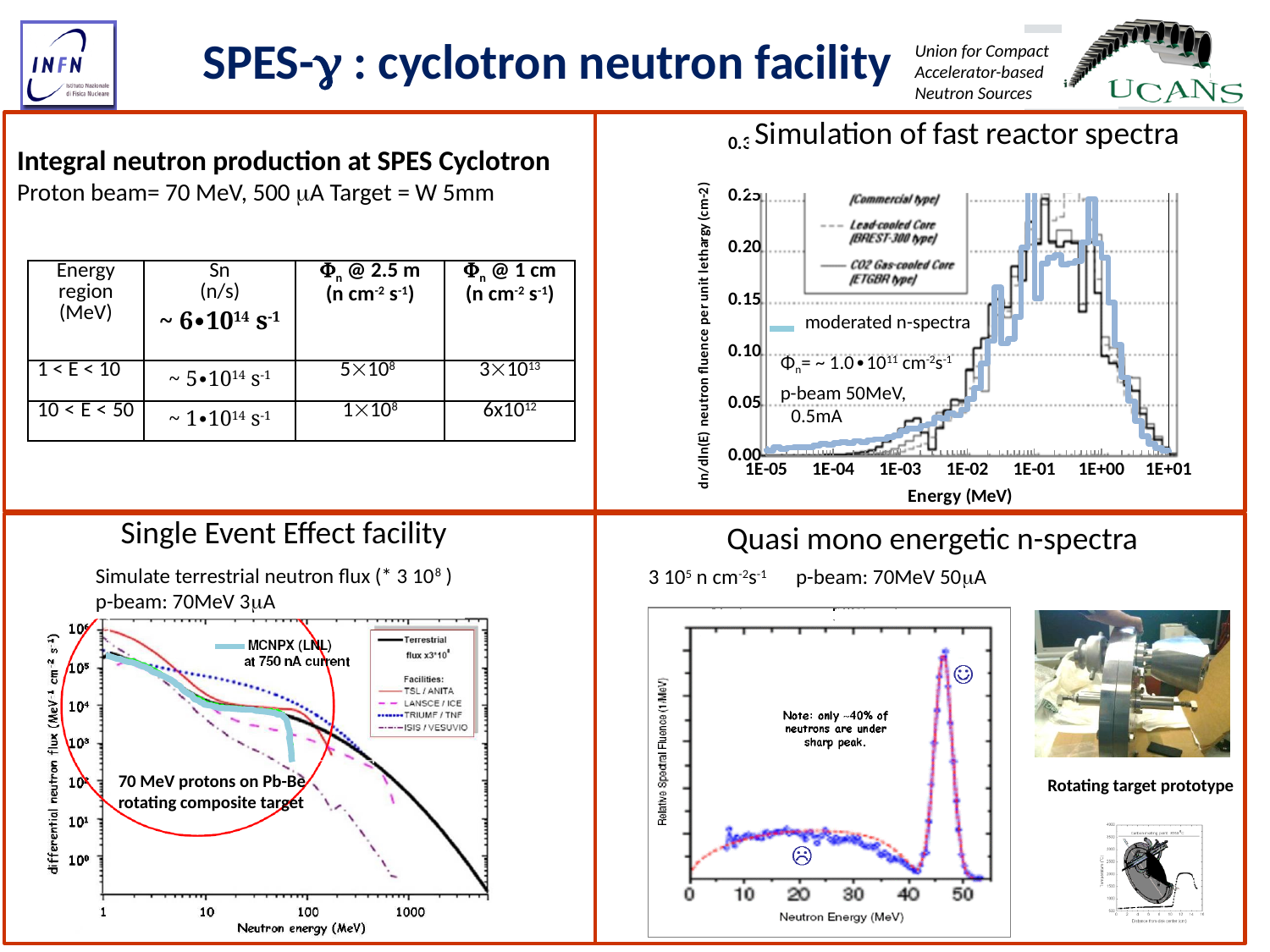
In the 'Simulation of fast reactor spectra' chart, how many energy ticks are labelled on the x axis? 7 In the 'Simulation of fast reactor spectra' chart, is the peak of the moderated n-spectra curve greater or less than 0.20? greater What kind of chart is the 'Simulation of fast reactor spectra' chart in the top right? line chart In the 'Quasi mono energetic n-spectra' chart, is the sharp peak located at a neutron energy greater or less than 40 MeV? greater In the 'Single Event Effect facility' chart, is the MCNPX (LNL) flux at 1 MeV greater or less than 10^4? greater In the 'Quasi mono energetic n-spectra' chart, is the relative spectral fluence at 20 MeV greater or less than the value at the sharp peak? less In the 'Simulation of fast reactor spectra' chart, what is the lowest energy tick shown on the x axis? 1E-05 In the 'Simulation of fast reactor spectra' chart, what is the highest energy tick shown on the x axis? 1E+01 In the 'Single Event Effect facility' chart, does the differential neutron flux rise or fall as neutron energy increases? falls In the 'Quasi mono energetic n-spectra' chart, what is the highest neutron energy tick labelled on the x axis? 50 In the 'Simulation of fast reactor spectra' chart, which series is drawn as the thick light-blue line? moderated n-spectra In the 'Simulation of fast reactor spectra' chart, what is the label of the x axis? Energy (MeV)